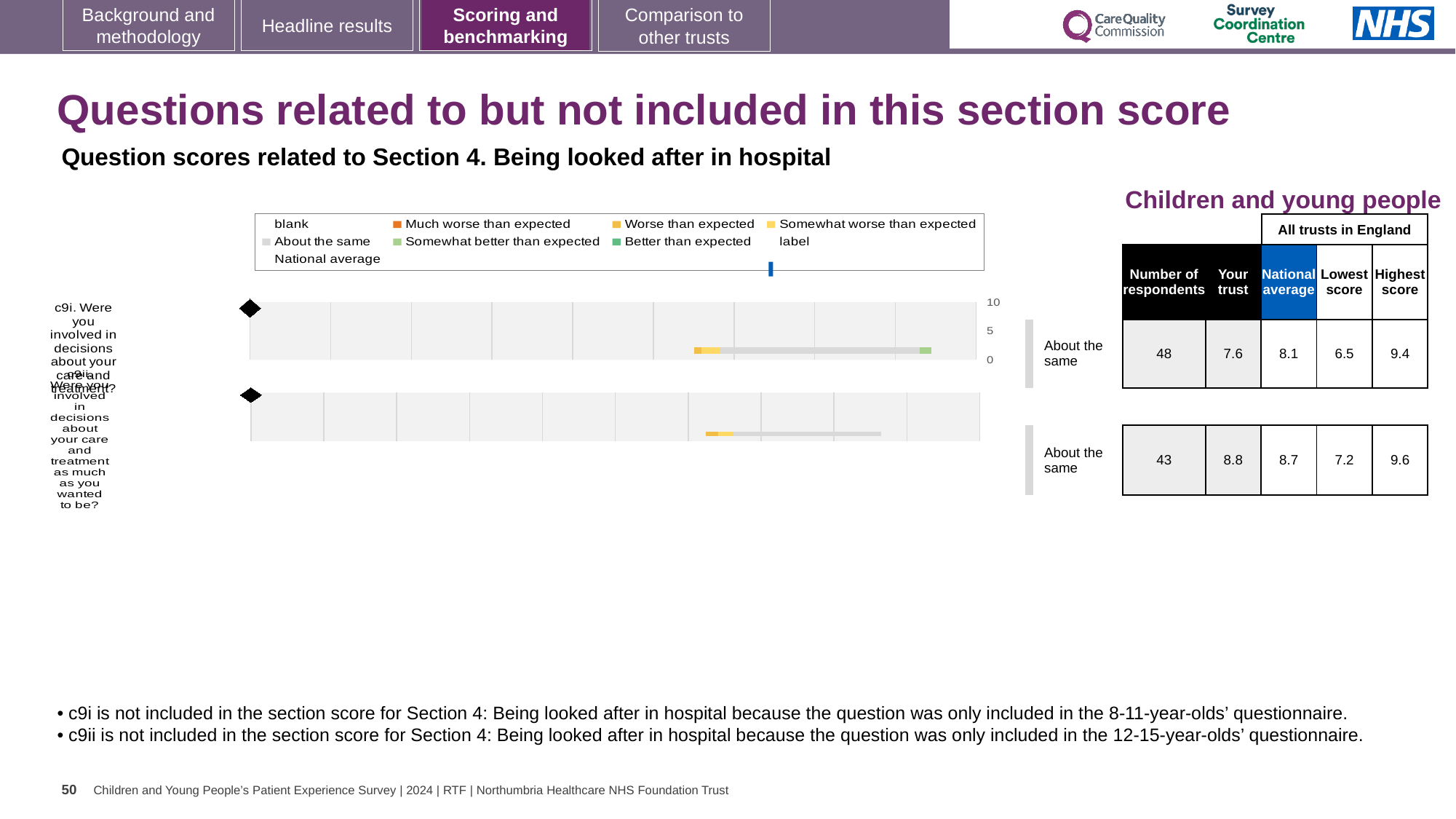
What is the maximum value shown on the chart's score axis? 10 What is the difference between the highest and lowest trust scores for question c9i? 2.9 What is the 'Your trust' score for question c9i? 7.6 What is the highest score among all trusts in England for question c9ii? 9.6 How many respondents answered question c9i? 48 What is the national average score for question c9ii? 8.7 What benchmark category is shown for question c9i? About the same Which question has the higher 'Your trust' score, c9i or c9ii? c9ii How many questions are plotted on the chart? 2 By how much does the trust's score for c9ii exceed the national average for c9ii? 0.1 What kind of chart is used to show the question scores? Bar chart What is the lowest score among all trusts in England for question c9i? 6.5